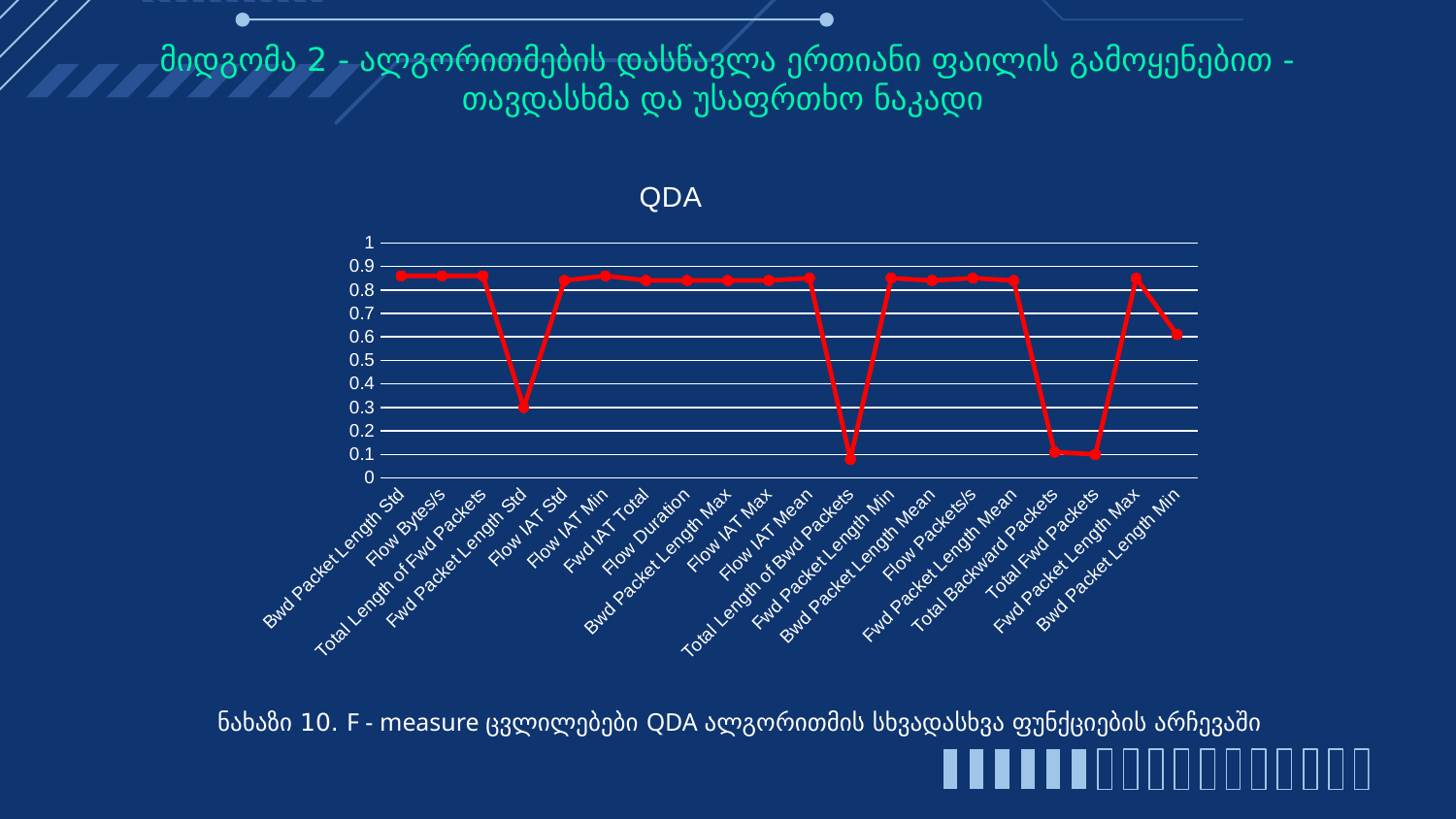
What is the title of the chart? QDA Which has the larger value, Bwd Packet Length Min or Total Fwd Packets? Bwd Packet Length Min Is the value for Fwd Packet Length Std greater or less than 0.5? less Is the value for Total Backward Packets greater or less than 0.3? less Which has the larger value, Flow IAT Std or Fwd Packet Length Std? Flow IAT Std Is the value for Bwd Packet Length Min greater or less than 0.5? greater What kind of chart is shown on the slide? line chart Which has the larger value, Flow Duration or Total Length of Bwd Packets? Flow Duration How many categories are plotted along the x axis of the chart? 20 What colour is the plotted line in the chart? red